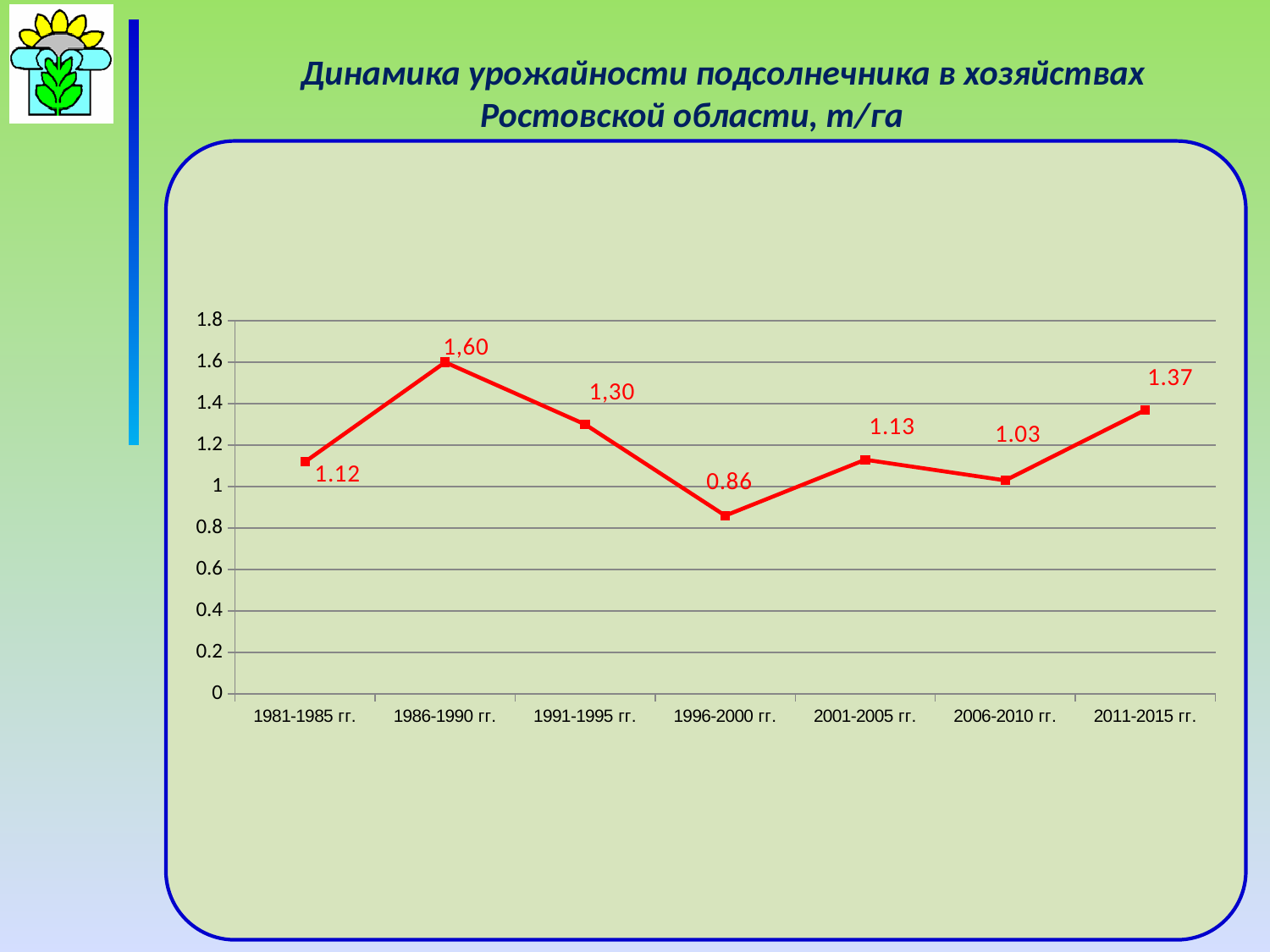
What is the value plotted for 2011-2015 гг.? 1.37 What is the difference between the values for 2001-2005 гг. and 2006-2010 гг.? 0.10 What kind of chart is shown on the slide? line chart Which period has the highest yield? 1986-1990 гг. What is the value plotted for 1981-1985 гг.? 1.12 Does the value rise or fall from 1986-1990 гг. to 1996-2000 гг.? fall What is the value plotted for 1996-2000 гг.? 0.86 Is the value for 1996-2000 гг. greater or less than 1? less How many periods are plotted on the x axis? 7 What is the sunflower yield for 1986-1990 гг.? 1,60 Which period has the lowest yield? 1996-2000 гг.